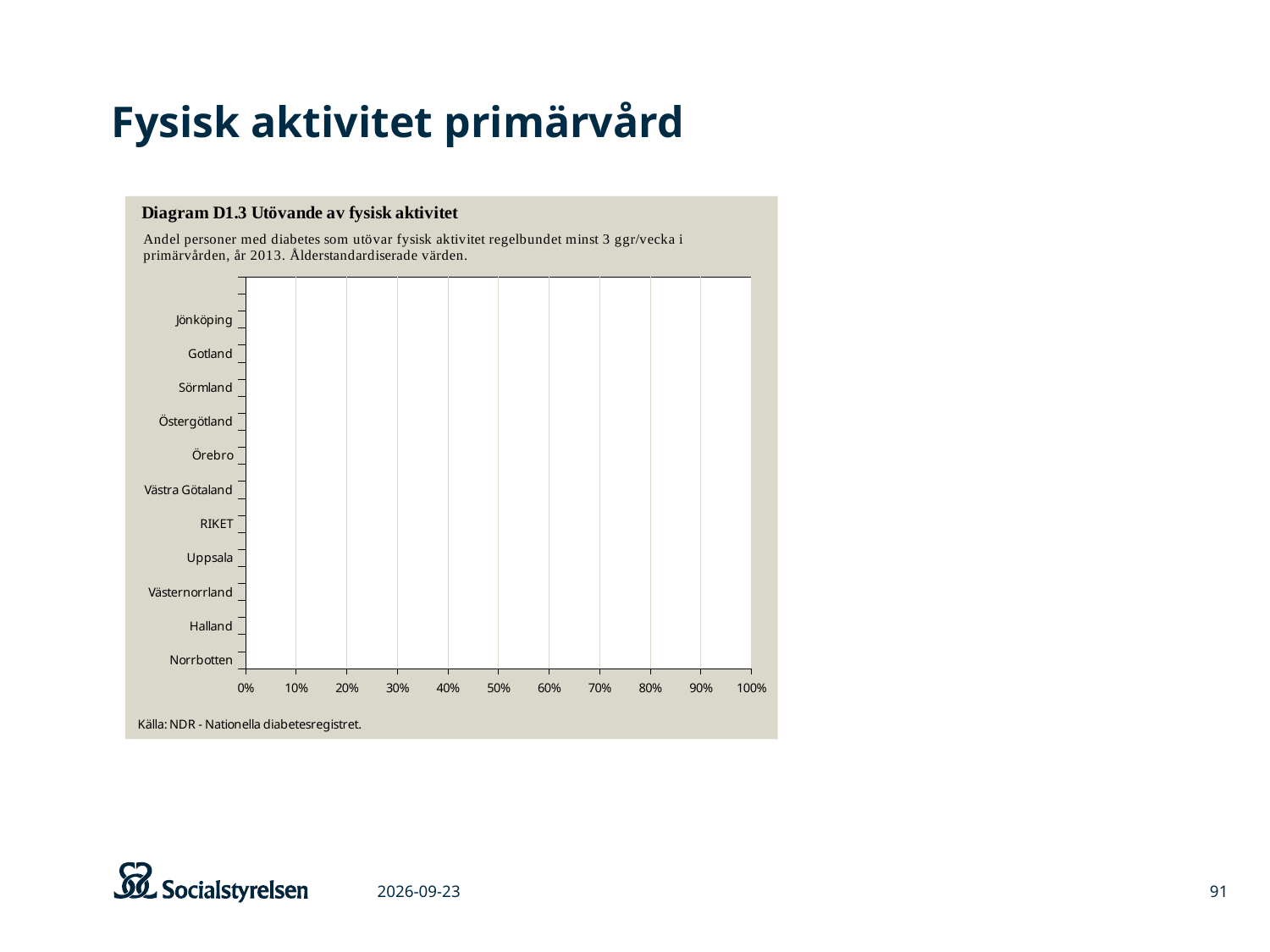
Which category label appears at the bottom of the vertical axis? Norrbotten What is the highest value shown on the horizontal axis of the chart? 100% What is the interval between consecutive tick labels on the horizontal axis? 10% What is the lowest value shown on the horizontal axis of the chart? 0% According to the note below the chart, what is the source of the data? NDR - Nationella diabetesregistret. Which year does the chart's subtitle say the data refers to? 2013 Which category label appears at the top of the vertical axis? Jönköping What is the title of the diagram shown on the slide? Diagram D1.3 Utövande av fysisk aktivitet